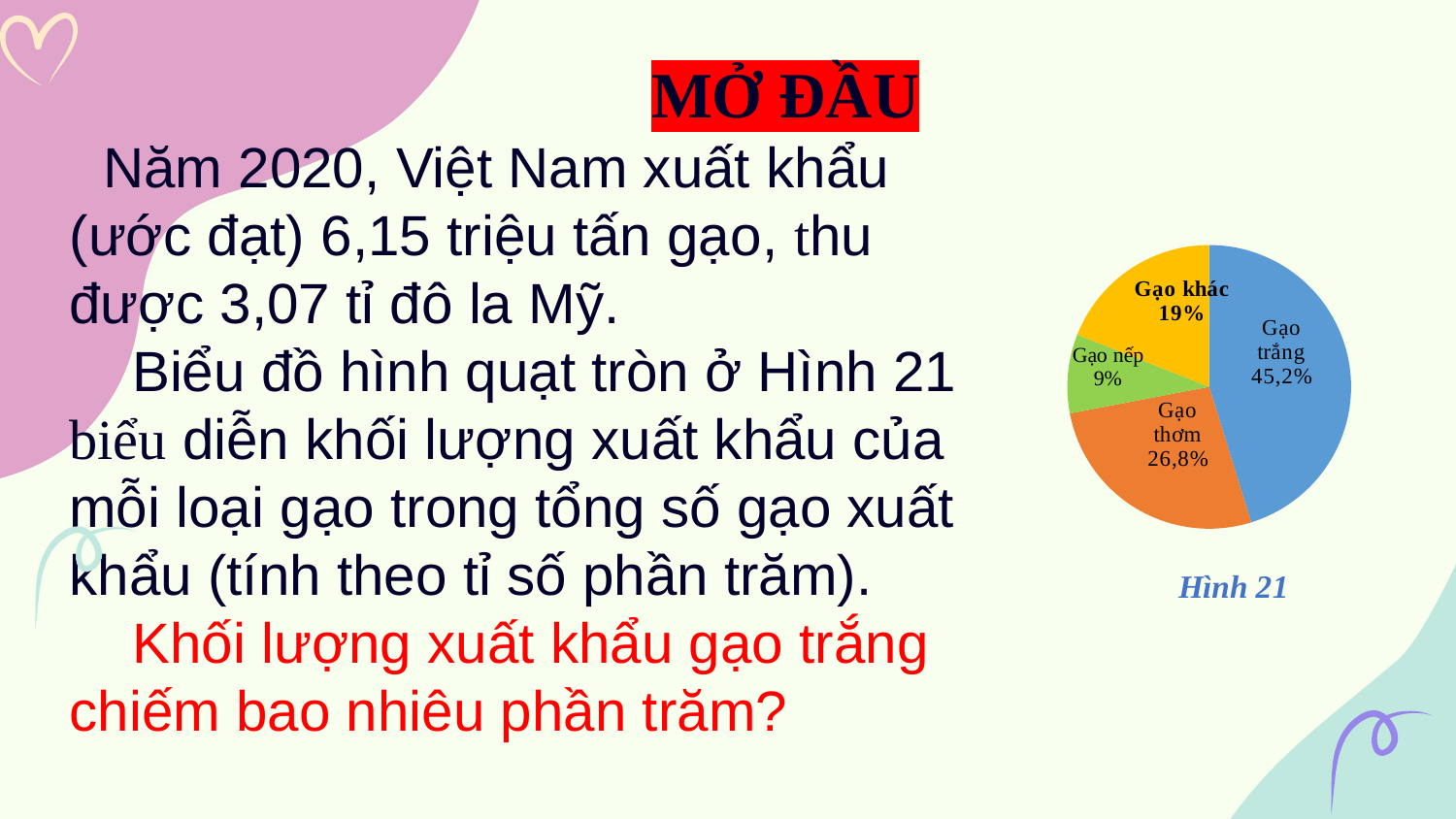
What kind of chart is shown in Hình 21? pie chart Which type of rice has the largest share of the pie? Gạo trắng What is the difference in percentage points between Gạo trắng and Gạo thơm? 18,4 Which is larger, the share for Gạo thơm or the share for Gạo khác? Gạo thơm How many slices does the pie chart have? 4 Which type of rice has the smallest share of the pie? Gạo nếp What is the difference in percentage points between Gạo khác and Gạo nếp? 10 What percentage does the Gạo trắng slice show? 45,2% What percentage does the Gạo khác slice show? 19% What percentage does the Gạo nếp slice show? 9% What is the caption written below the pie chart? Hình 21 What percentage does the Gạo thơm slice show? 26,8%